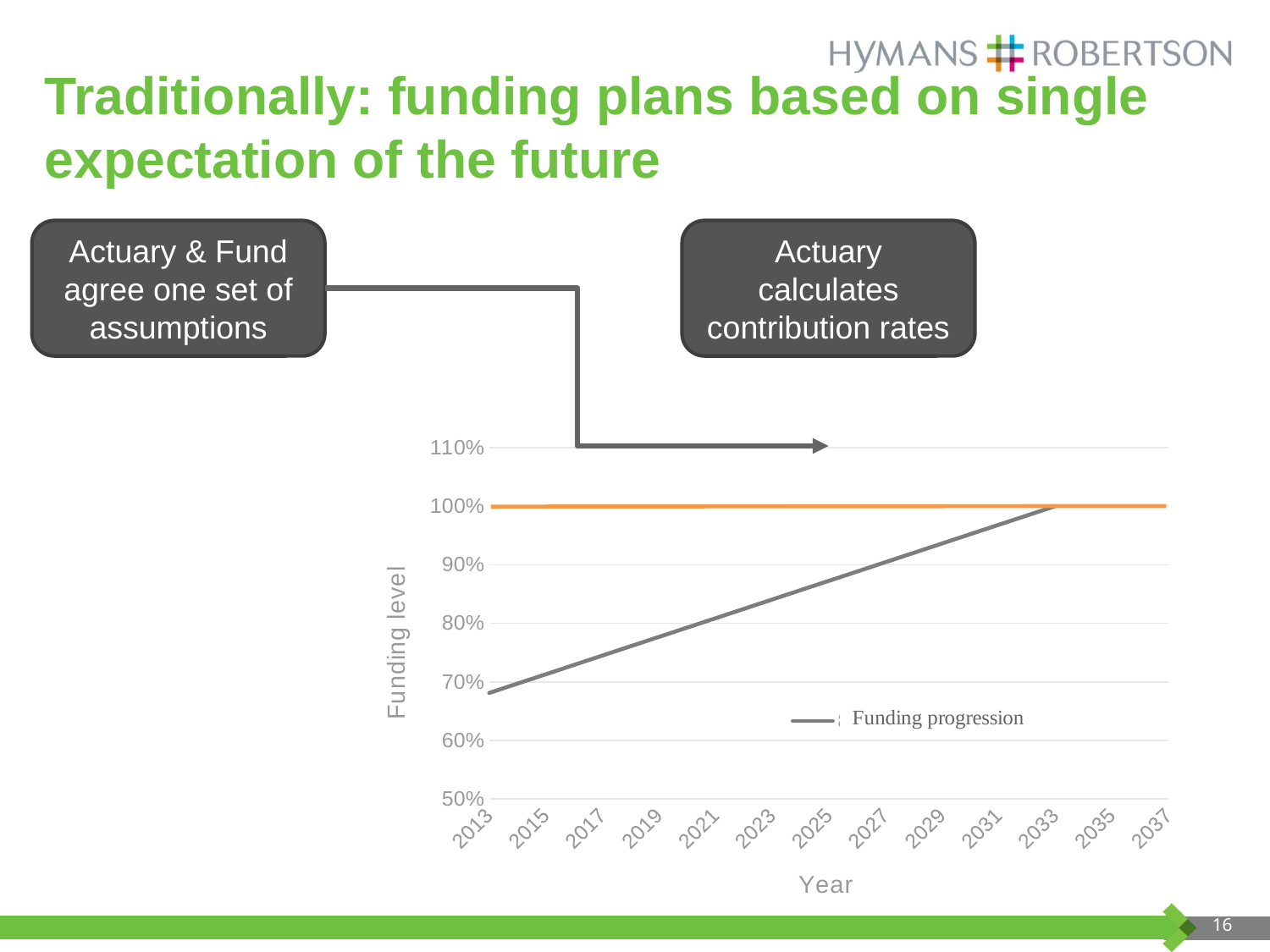
What series name is listed in the chart's legend? Funding progression Is the Funding progression value in 2013 greater or less than 70%? less Is the Funding progression value in 2019 greater or less than 80%? less At what funding level does the flat orange line sit? 100% What is the label of the y axis of the chart? Funding level Does the Funding progression line rise or fall between 2013 and 2033? rise What is the label of the x axis of the chart? Year What is the highest value shown on the y axis? 110% Is the Funding progression value in 2029 greater or less than 90%? greater What kind of chart is shown on the slide? line chart How many year labels are shown on the x axis? 13